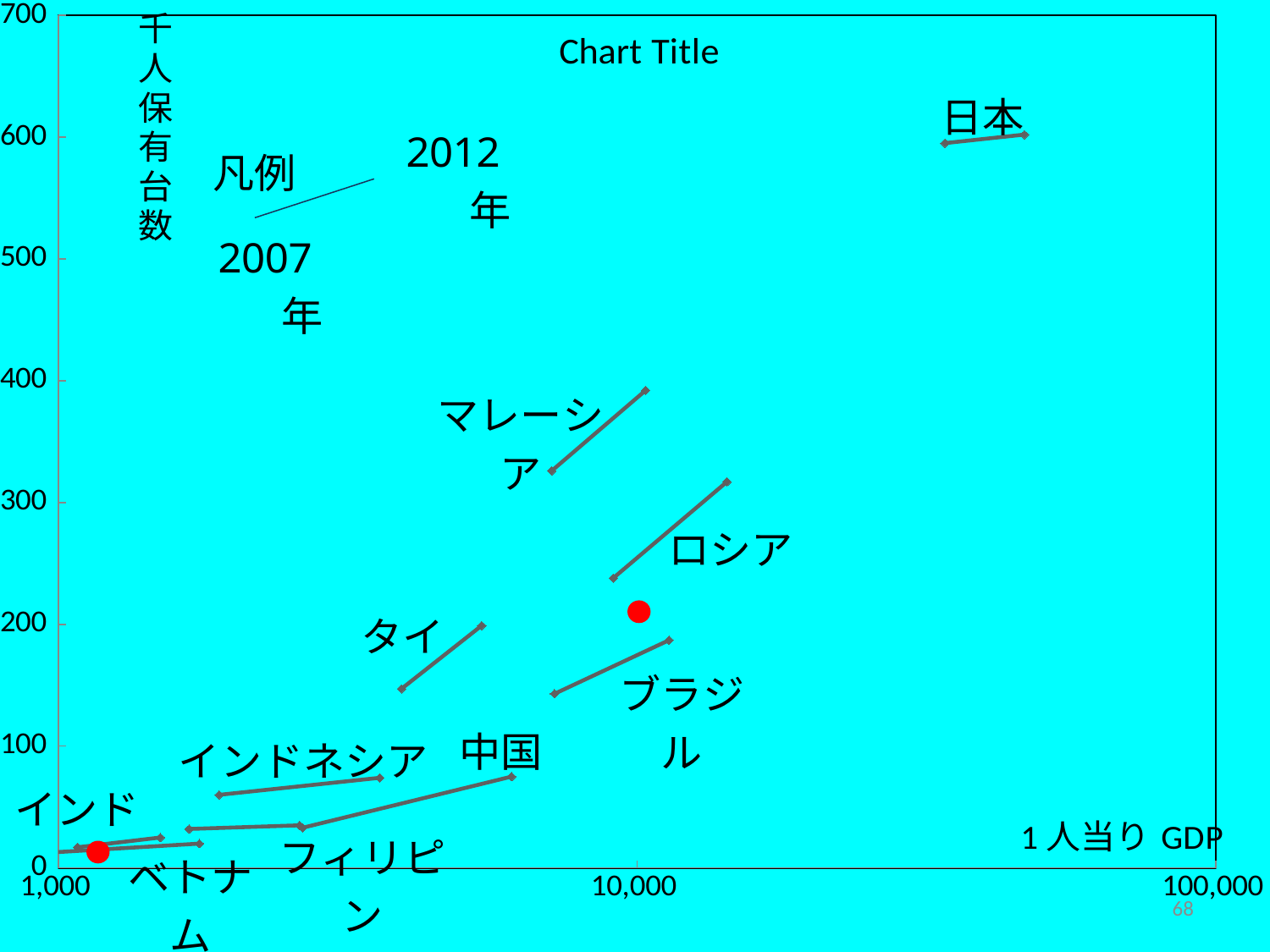
Do the 千人保有台数 values generally rise or fall as 1人当り GDP increases along the x axis? rise Is the 2012年 value for 日本 greater or less than 500? greater Is the 2007年 value for ロシア greater or less than 300? less What is the title of the chart? Chart Title Which country has the highest 千人保有台数 on the chart? 日本 What is the label on the x axis of the chart? 1人当り GDP Is the 2007年 value for ブラジル greater or less than 200? less Which has the larger 2012年 value, マレーシア or ロシア? マレーシア How many countries are plotted on the chart? 10